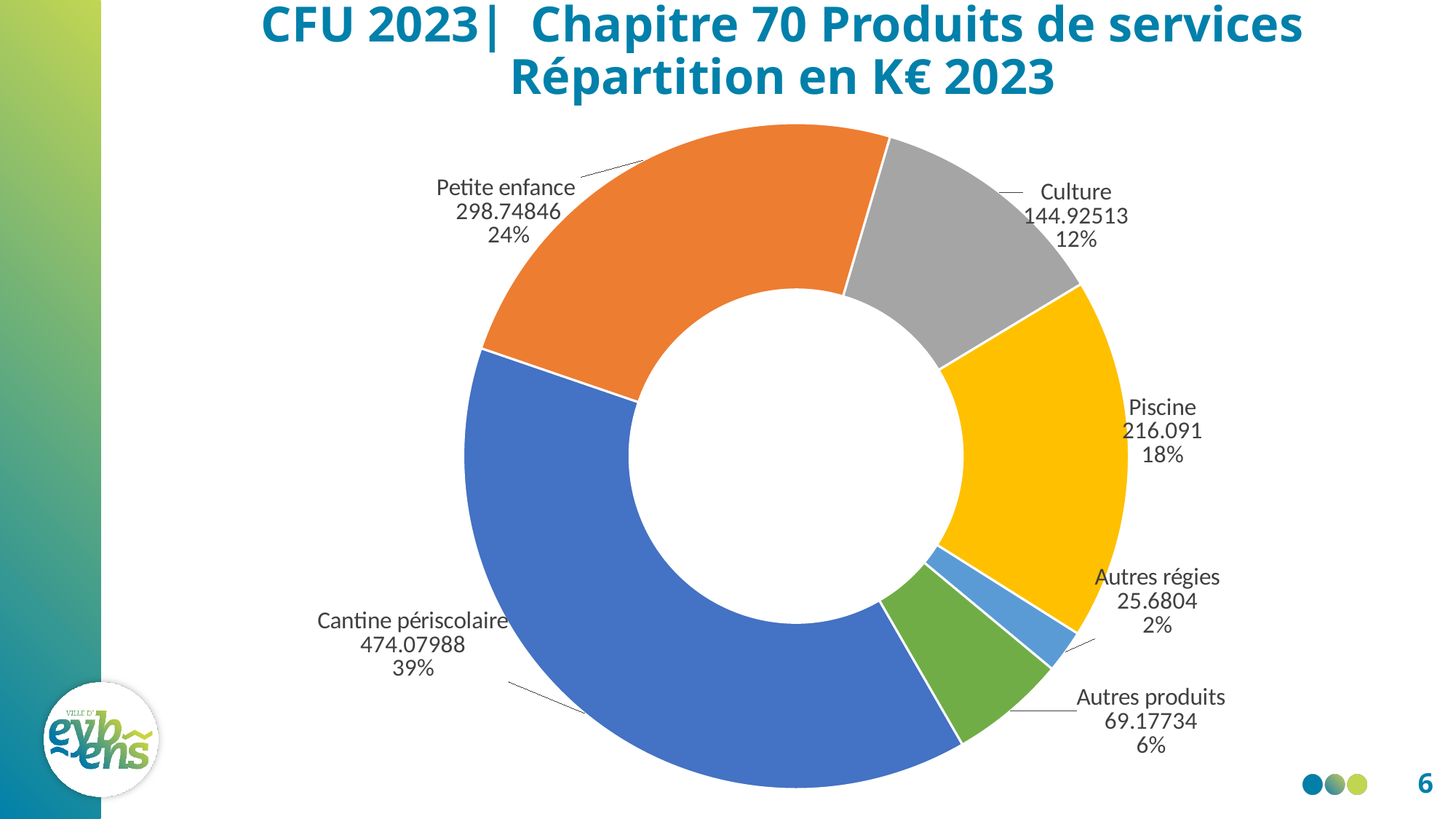
What is the title of the chart? CFU 2023| Chapitre 70 Produits de services Répartition en K€ 2023 What is the difference between the values for Piscine and Culture? 71.16587 What value is shown for Autres régies? 25.6804 What value is shown for Cantine périscolaire? 474.07988 What share of the total does Petite enfance represent? 24% Which is larger, Culture or Piscine? Piscine What value is shown for Piscine? 216.091 Which category has the largest slice? Cantine périscolaire What is the difference between the values for Cantine périscolaire and Petite enfance? 175.33142 What kind of chart is shown on the slide? doughnut (pie) chart How many categories does the chart show? 6 Which category has the smallest slice? Autres régies